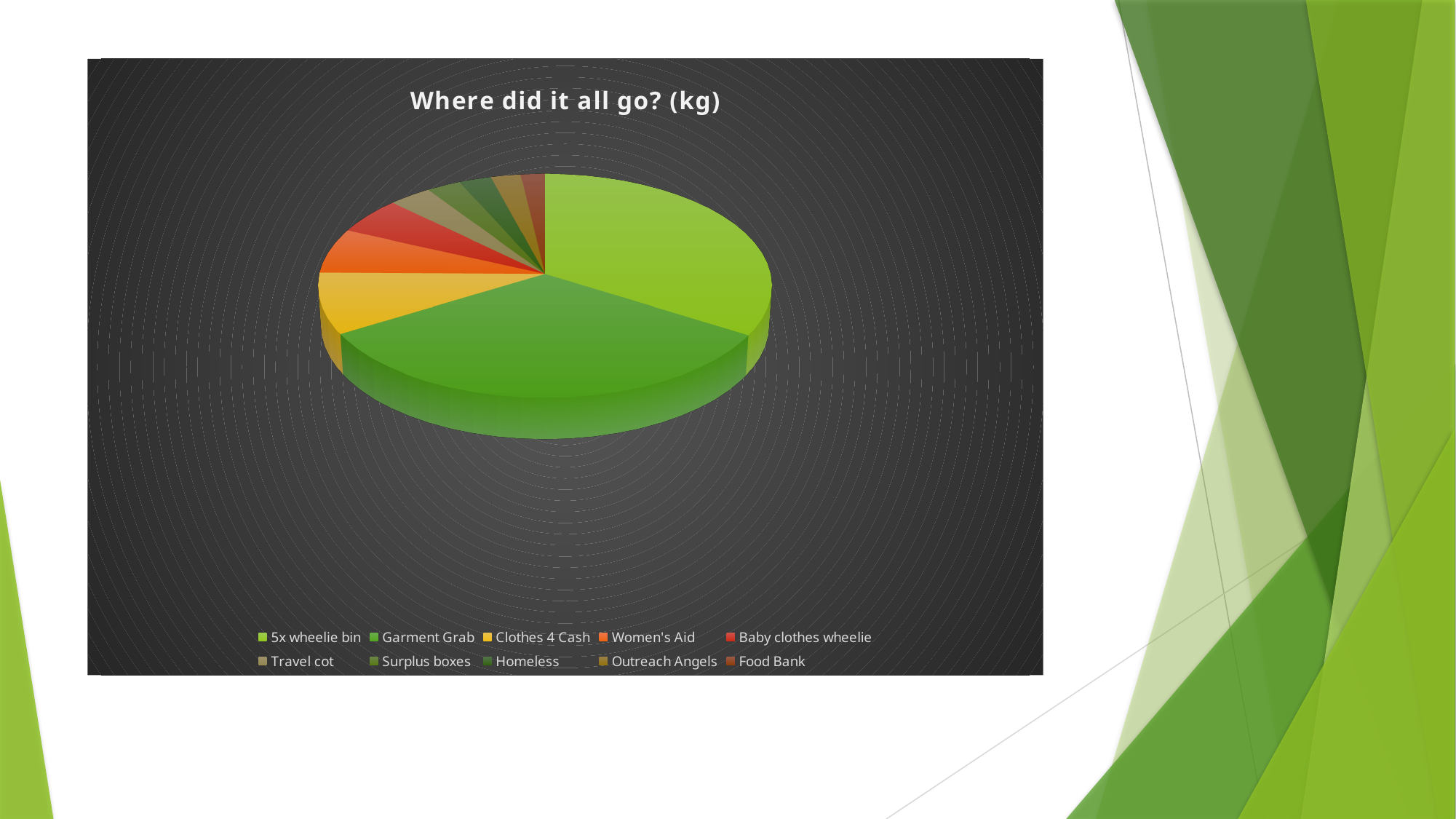
Which is larger, the slice for 5x wheelie bin or the slice for Food Bank? 5x wheelie bin How many categories does the pie chart's legend list? 10 What is the title of the chart? Where did it all go? (kg) Which is larger, the slice for Garment Grab or the slice for Homeless? Garment Grab Which is larger, the slice for 5x wheelie bin or the slice for Baby clothes wheelie? 5x wheelie bin What unit is indicated in the chart title? kg What kind of chart is shown on the slide? Pie chart